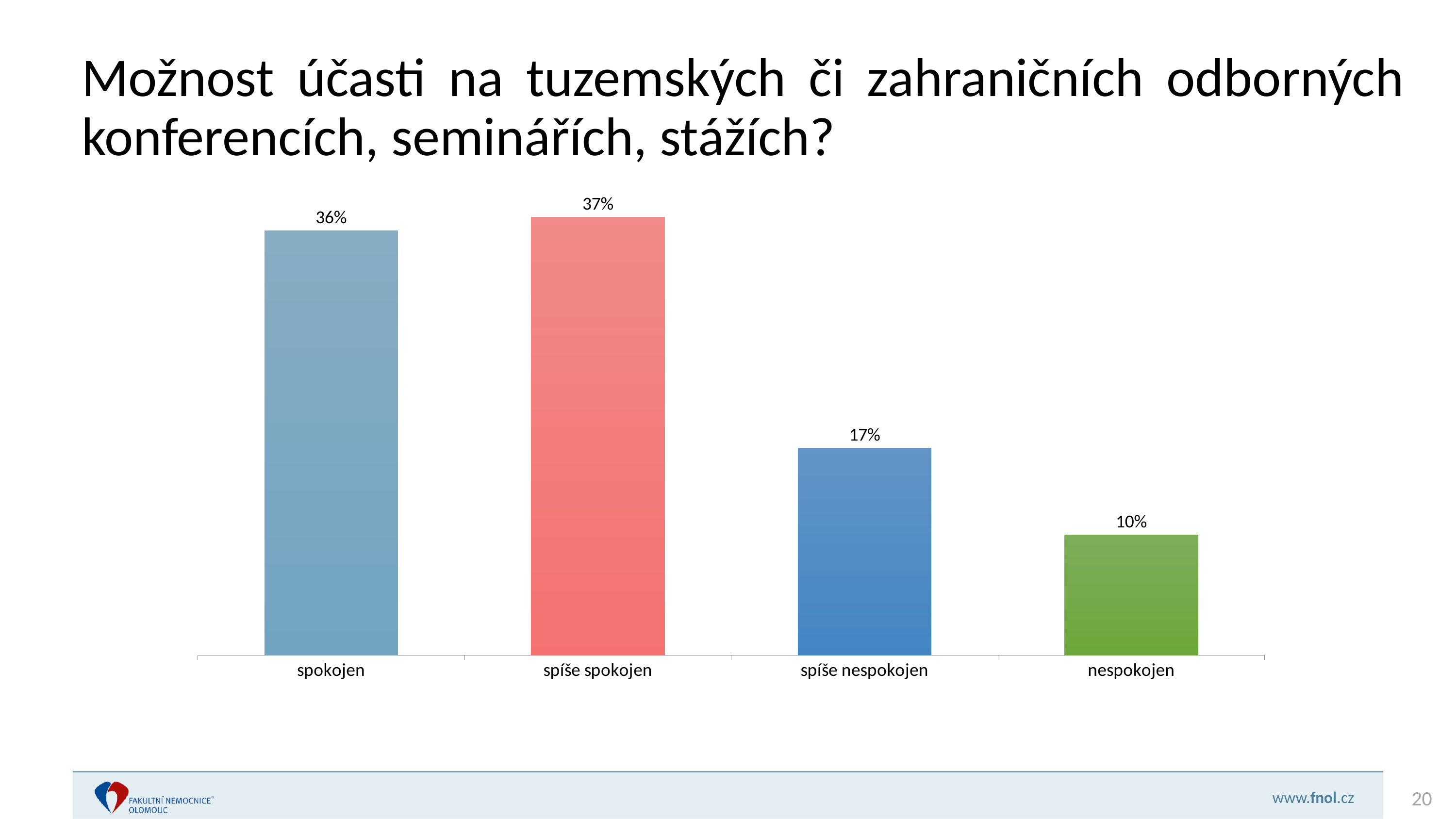
Which category has the highest value? spíše spokojen How many categories are shown on the chart? 4 What is the value for "spíše nespokojen"? 17% What is the value for "nespokojen"? 10% What is the difference between the values for "spokojen" and "nespokojen"? 26% What is the difference between the values for "spíše spokojen" and "spíše nespokojen"? 20% What kind of chart is shown on the slide? bar chart What colour is the bar for "spíše spokojen"? red What is the value for "spíše spokojen"? 37% Which category has the lowest value? nespokojen Which is larger, the value for "spíše nespokojen" or the value for "nespokojen"? spíše nespokojen What is the value for "spokojen"? 36%